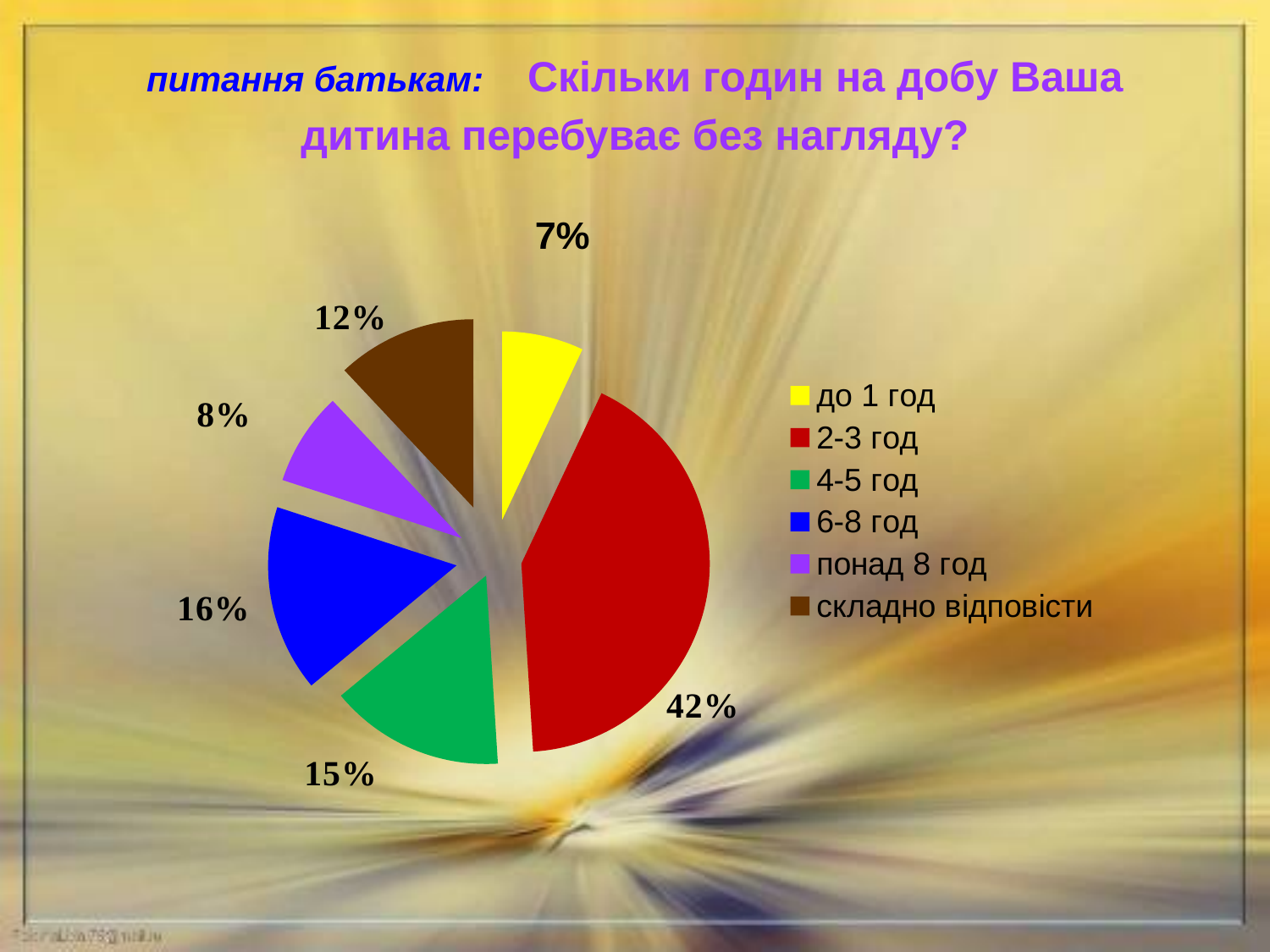
What is the value for "складно відповісти"? 12% What share of the pie does the "2-3 год" slice have? 42% How many categories does the pie chart have? 6 What is the value for "до 1 год"? 7% What kind of chart is shown on the slide? pie chart Which category has the largest slice of the pie? 2-3 год What is the difference between the values for "6-8 год" and "понад 8 год"? 8% What is the value for "6-8 год"? 16% What colour is the slice for "4-5 год"? green Which category has the smallest slice of the pie? до 1 год Which is larger, the value for "понад 8 год" or the value for "складно відповісти"? складно відповісти What is the difference between the values for "2-3 год" and "4-5 год"? 27%